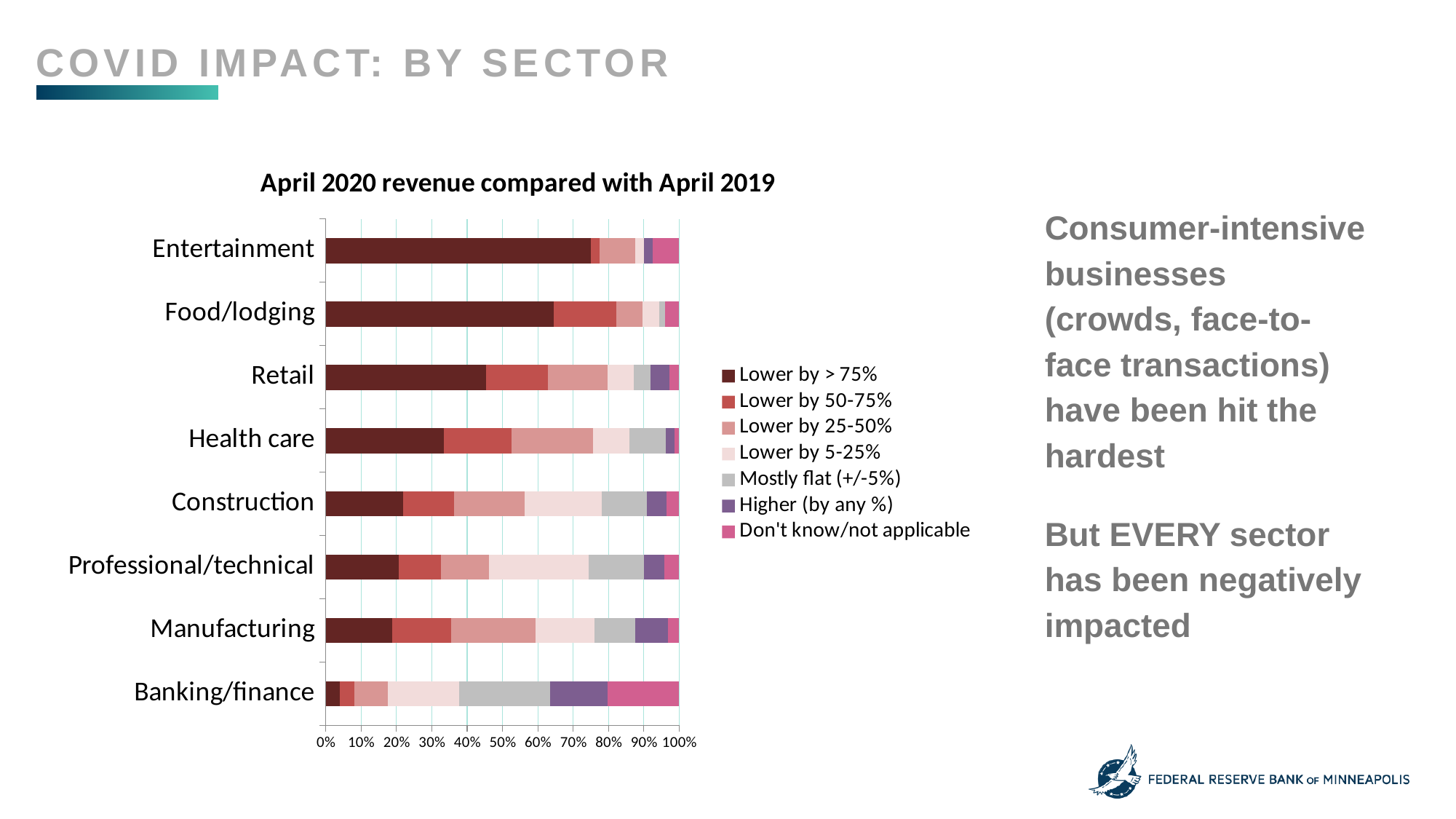
Which sector has the smallest 'Lower by > 75%' share? Banking/finance How many sectors are shown on the chart? 8 How many series does the chart's legend list? 7 Which sector has the largest 'Higher (by any %)' share? Banking/finance Is the 'Lower by > 75%' share for Retail greater or less than 50%? less What kind of chart is shown on the slide? Bar chart Is the 'Lower by > 75%' share for Banking/finance greater or less than 10%? less Which sector has the larger 'Lower by > 75%' share, Entertainment or Food/lodging? Entertainment Which sector has the largest 'Mostly flat (+/-5%)' share? Banking/finance What is the title of the chart? April 2020 revenue compared with April 2019 Which sector has the largest 'Lower by > 75%' share? Entertainment Is the 'Lower by > 75%' share for Entertainment greater or less than 70%? greater